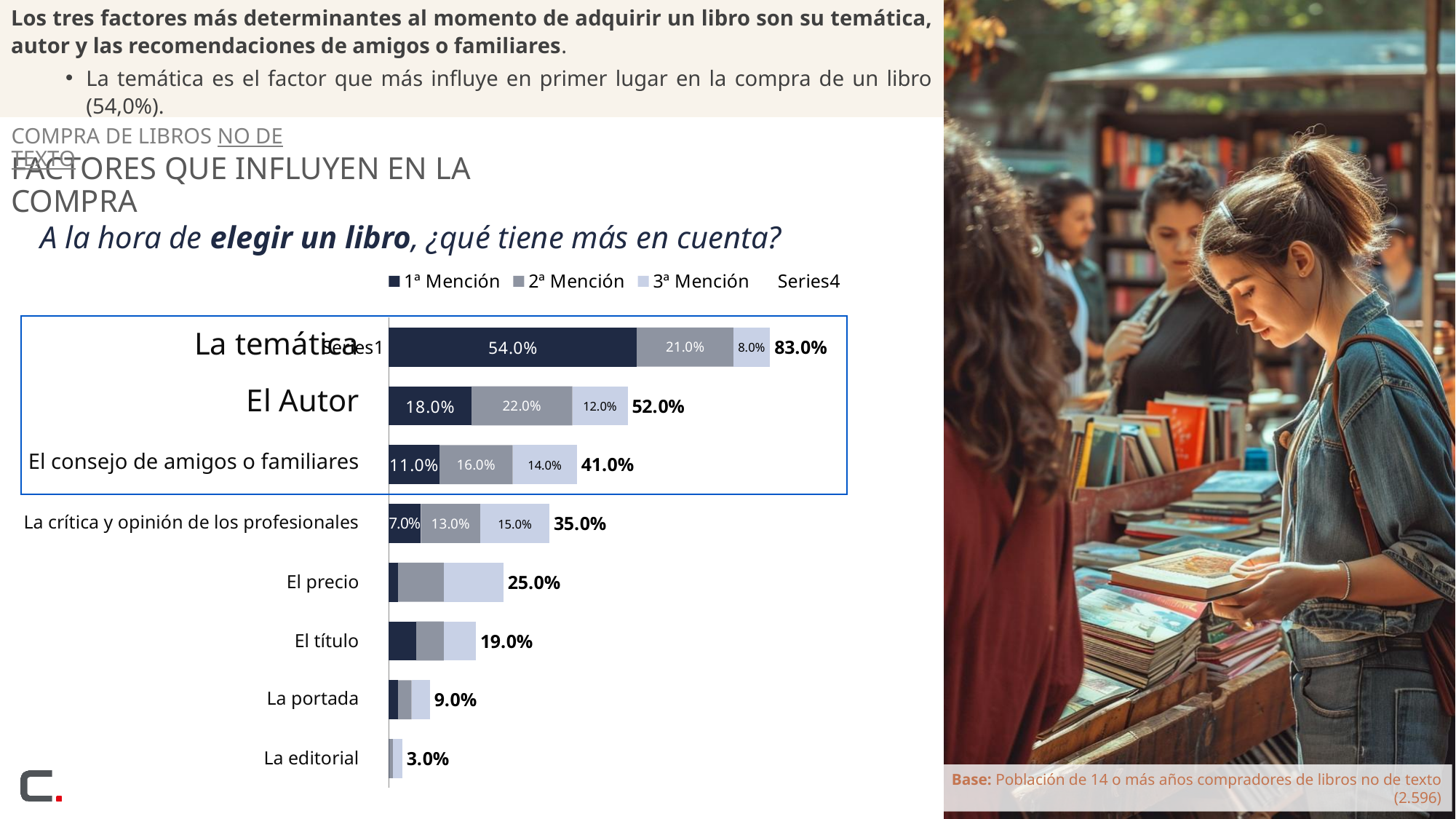
What is the 3ª Mención value for El consejo de amigos o familiares? 14.0% How many categories are shown in the chart? 8 What is the 1ª Mención value for La temática? 54.0% What is the 2ª Mención value for La crítica y opinión de los profesionales? 13.0% What is the total value shown for El Autor? 52.0% What is the difference between the total values for La temática and El Autor? 31.0% Which has a larger total value, El precio or El título? El precio What type of chart is shown on the slide? Stacked bar chart How many entries does the legend list? 4 What is the total value shown for La portada? 9.0% Which category has the highest total value? La temática Which category has the lowest total value? La editorial